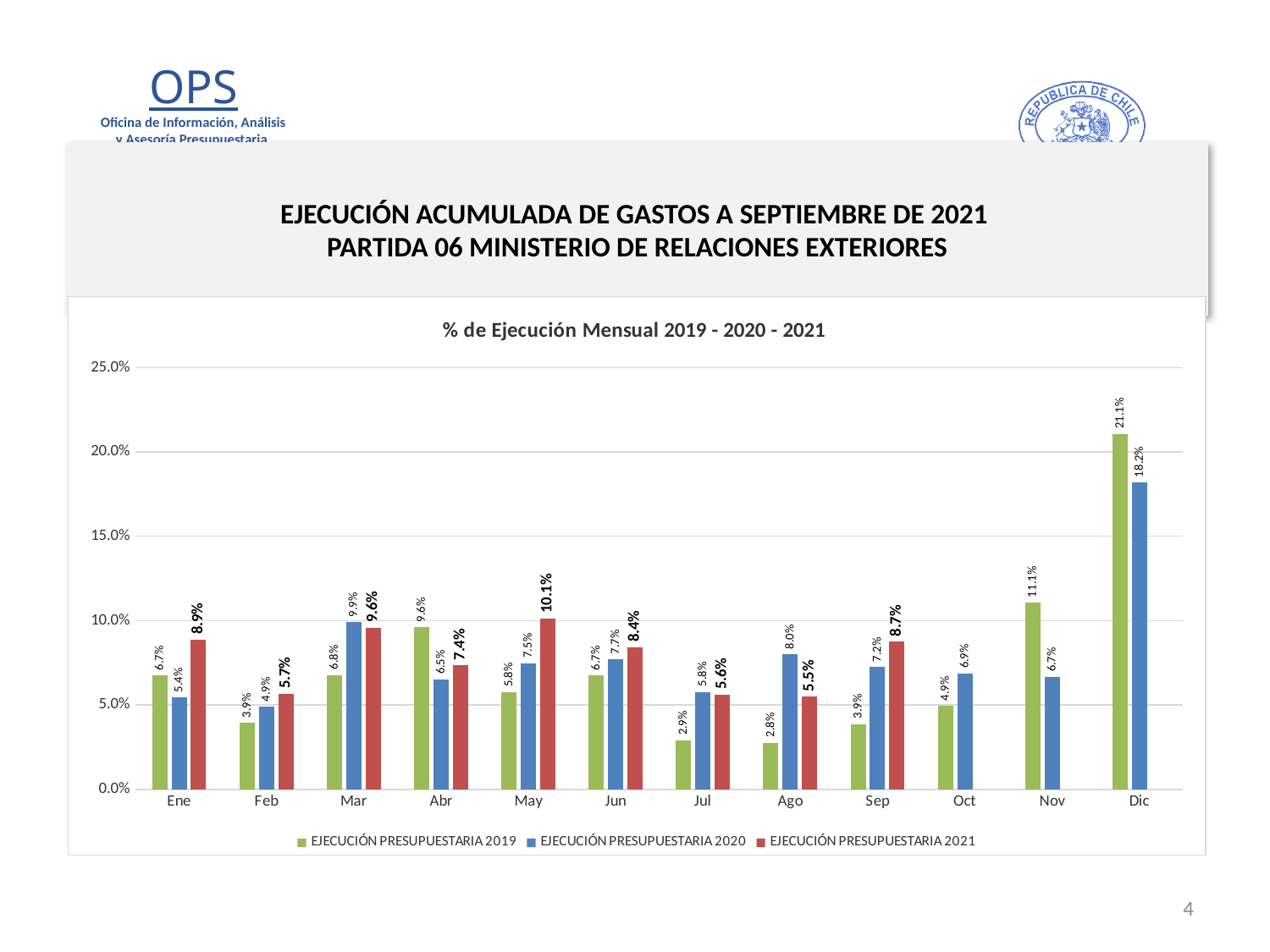
What is the value for EJECUCIÓN PRESUPUESTARIA 2021 in May? 10.1% What kind of chart is shown? Bar chart How many months are shown on the x axis? 12 Which month has the highest value for EJECUCIÓN PRESUPUESTARIA 2021? May What is the title of the chart? % de Ejecución Mensual 2019 - 2020 - 2021 What is the value for EJECUCIÓN PRESUPUESTARIA 2020 in Ago? 8.0% Which month has the lowest value for EJECUCIÓN PRESUPUESTARIA 2019? Ago How many series does the legend list? 3 Is the value for EJECUCIÓN PRESUPUESTARIA 2019 in Nov greater or less than 10.0%? greater What is the value for EJECUCIÓN PRESUPUESTARIA 2019 in Dic? 21.1% What is the difference between the EJECUCIÓN PRESUPUESTARIA 2019 and 2020 values in Dic? 2.9% In Sep, which series has the larger value: EJECUCIÓN PRESUPUESTARIA 2020 or EJECUCIÓN PRESUPUESTARIA 2021? EJECUCIÓN PRESUPUESTARIA 2021